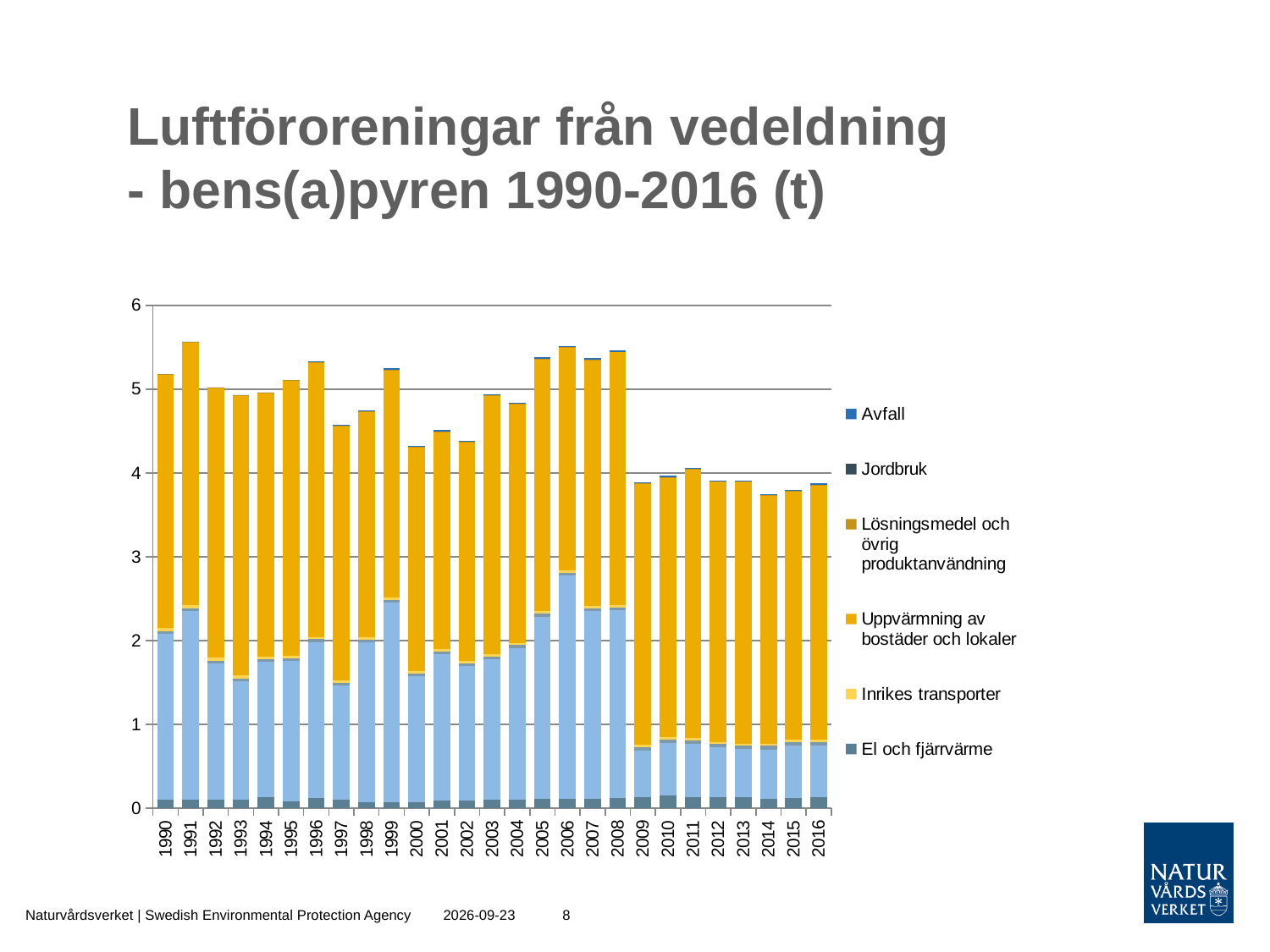
What kind of chart is shown on the slide? stacked bar chart Is the total value for 2000 greater or less than 5? less Overall, do the total values rise or fall from 1990 to 2016? fall How many years are shown along the x axis of the chart? 27 Is the total value for 2014 greater or less than 4? less Is the total value for 2006 greater or less than 5? greater How many series does the legend list? 6 Which year has the larger total, 2008 or 2009? 2008 Which legend entry is shown in the dark orange/yellow colour that makes up the largest part of each bar? Uppvärmning av bostäder och lokaler What is the title of the chart on the slide? Luftföroreningar från vedeldning - bens(a)pyren 1990-2016 (t) Which year has the larger total, 1999 or 2000? 1999